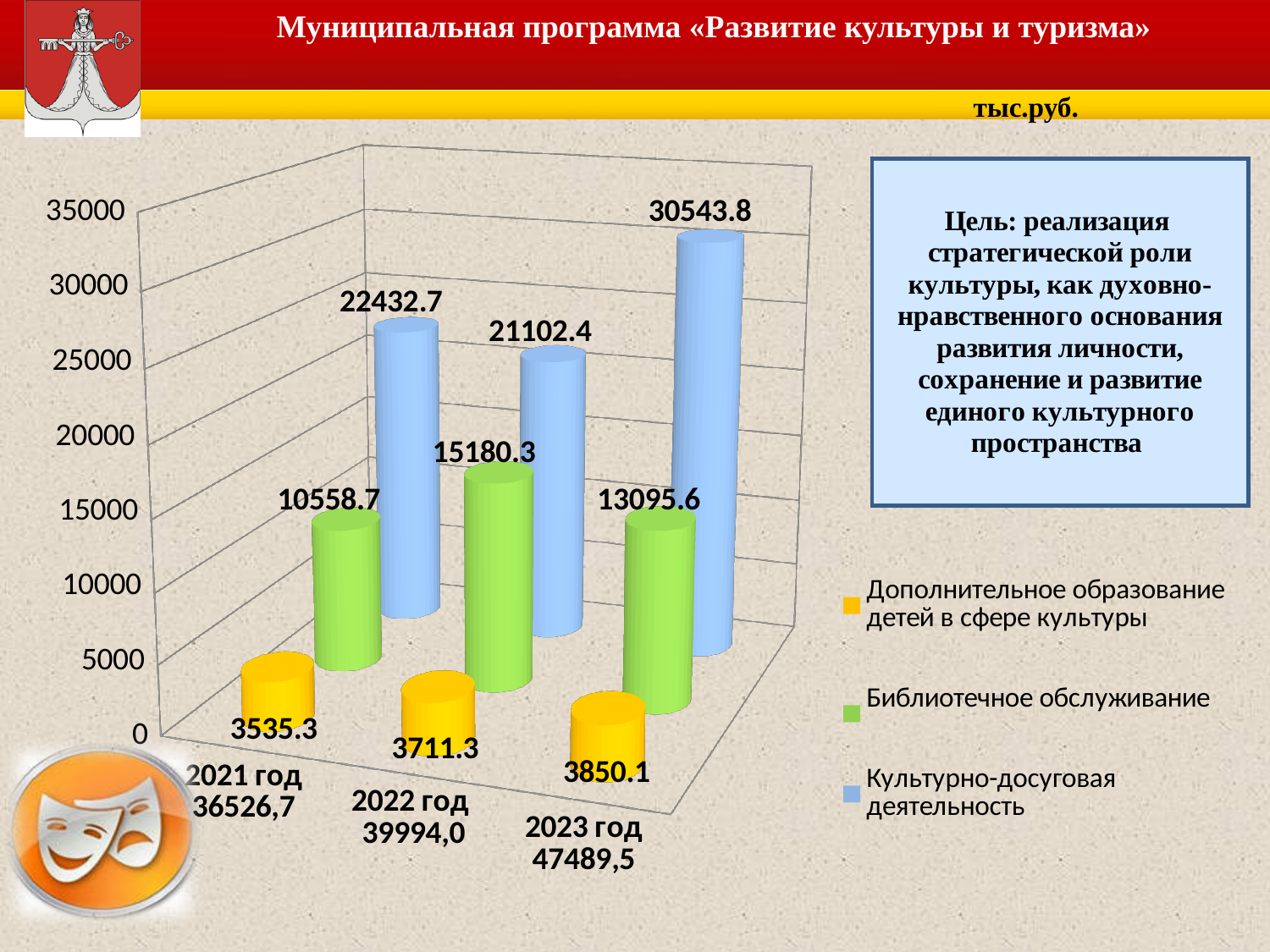
Do the values for Дополнительное образование детей в сфере культуры rise or fall from 2021 год to 2023 год? rise Is the value for Культурно-досуговая деятельность in 2021 год greater or less than 20000? greater How many series does the legend list? 3 How many years are shown on the x axis of the chart? 3 What kind of chart is shown on the slide? bar chart What is the value for Культурно-досуговая деятельность in 2023 год? 30543.8 What is the difference between the Культурно-досуговая деятельность values for 2023 год and 2022 год? 9441.4 What is the value for Дополнительное образование детей в сфере культуры in 2021 год? 3535.3 In which year is the value for Библиотечное обслуживание the lowest? 2021 год Which is larger: Библиотечное обслуживание in 2022 год or in 2023 год? 2022 год What is the value for Библиотечное обслуживание in 2022 год? 15180.3 In which year is the value for Культурно-досуговая деятельность the highest? 2023 год